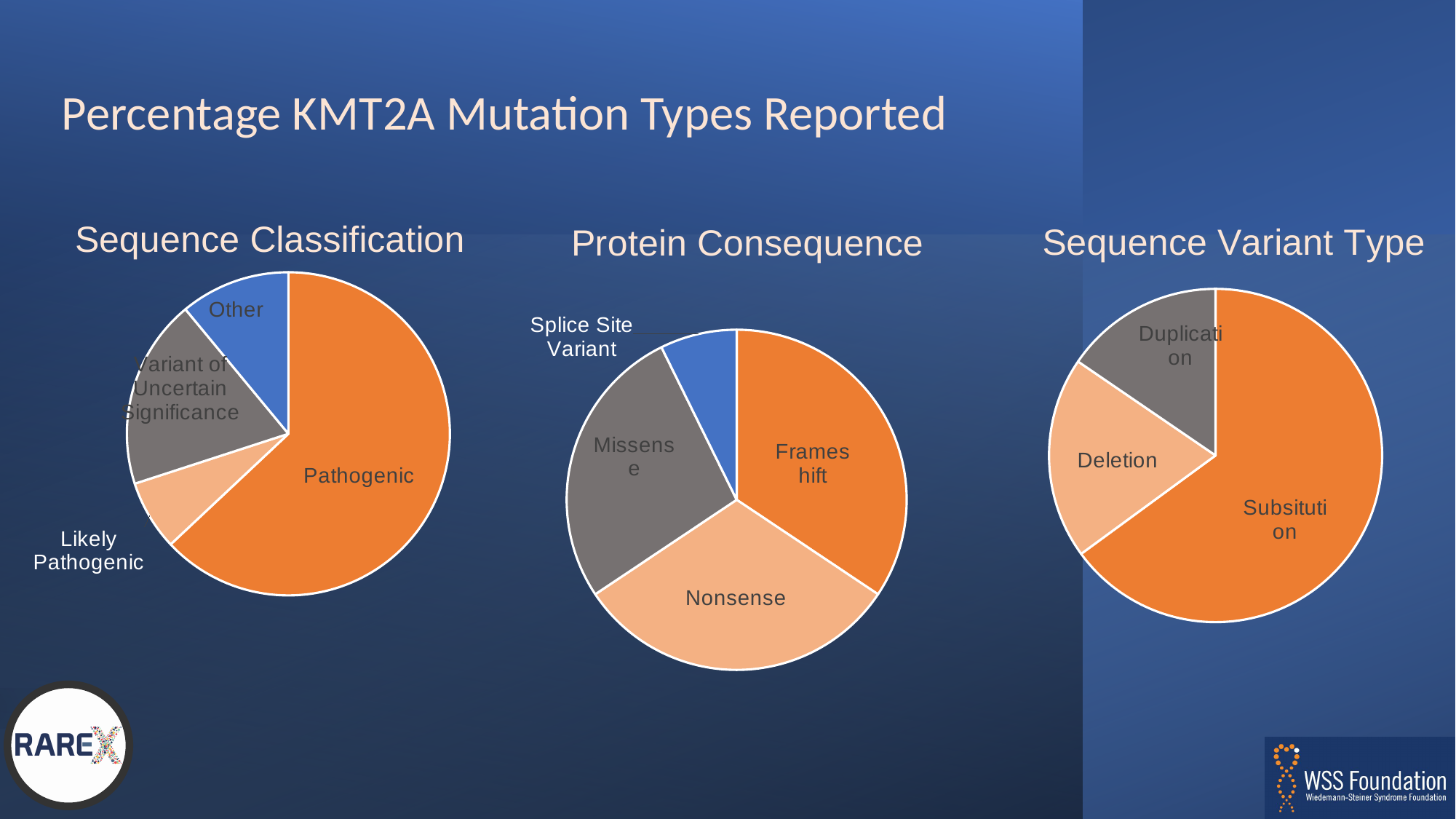
What kind of chart is the Sequence Classification chart? pie chart In the Sequence Variant Type chart, which category has the largest slice? Subsitution In the Protein Consequence chart, which category has the smallest slice? Splice Site Variant What is the title of the slide containing the three pie charts? Percentage KMT2A Mutation Types Reported In the Sequence Classification chart, how many slices does the pie have? 4 In the Sequence Classification chart, which category has the largest slice? Pathogenic In the Sequence Variant Type chart, how many slices does the pie have? 3 In the Protein Consequence chart, which slice is larger: Nonsense or Splice Site Variant? Nonsense In the Protein Consequence chart, how many slices does the pie have? 4 In the Sequence Variant Type chart, which slice is larger: Deletion or Substitution? Subsitution In the Sequence Classification chart, which slice is larger: Pathogenic or Variant of Uncertain Significance? Pathogenic